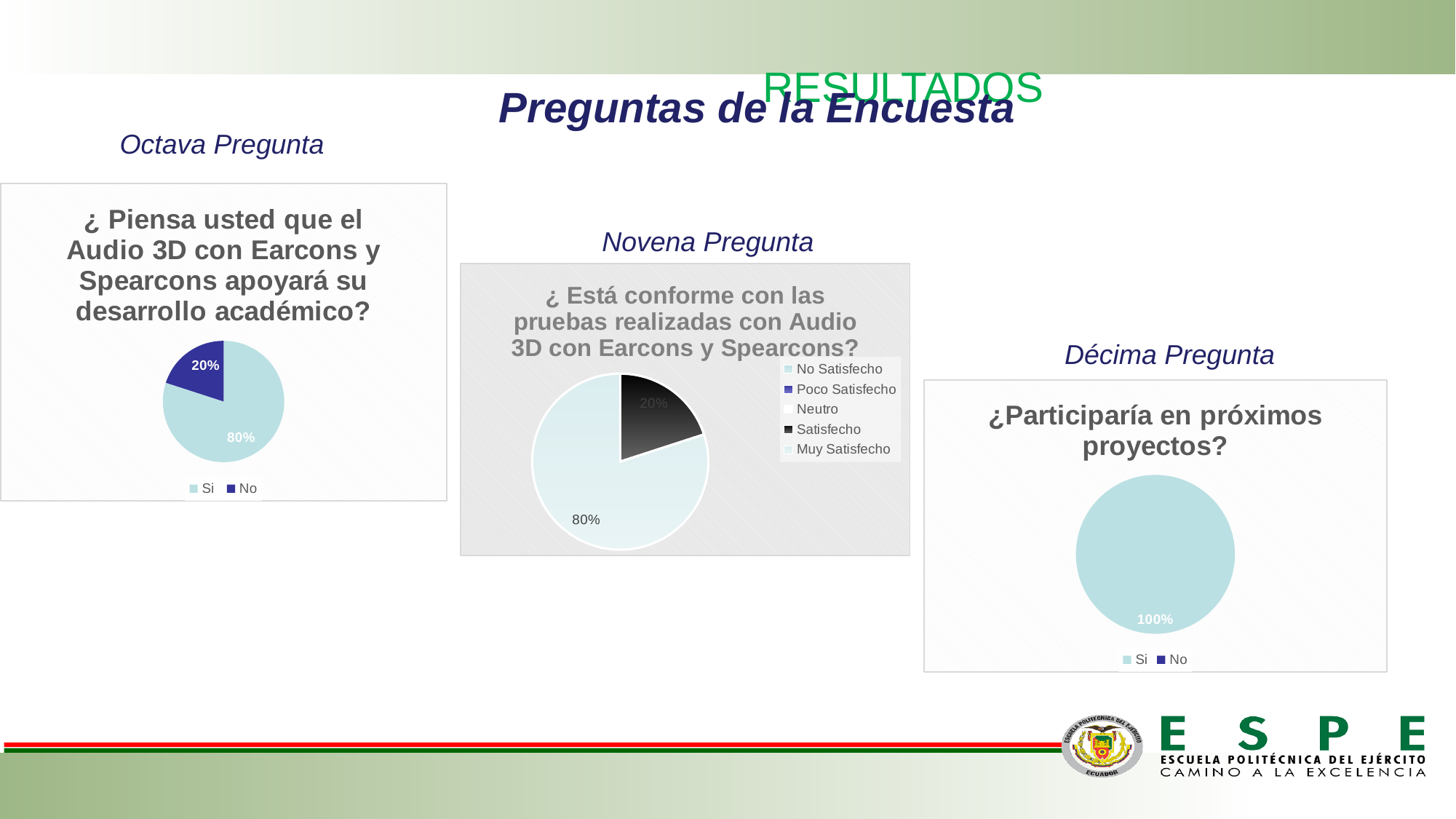
In the Octava Pregunta chart, what is the difference in percentage points between Si and No? 60 In the Novena Pregunta chart, how many entries does the legend list? 5 In the Octava Pregunta chart, how many entries does the legend list? 2 How many charts are shown on the slide? 3 In the Novena Pregunta chart, what percentage is shown for the Muy Satisfecho slice? 80% In the Novena Pregunta chart, what percentage is shown for the Satisfecho slice? 20% In the Octava Pregunta chart, what percentage of respondents answered No? 20% In the Octava Pregunta chart, which answer has the largest share? Si In the Octava Pregunta chart, what percentage of respondents answered Si? 80% What type of chart is used for the Décima Pregunta? Pie chart In the Novena Pregunta chart, which is larger, the Satisfecho slice or the Muy Satisfecho slice? Muy Satisfecho In the Décima Pregunta chart, what percentage of respondents answered Si? 100%